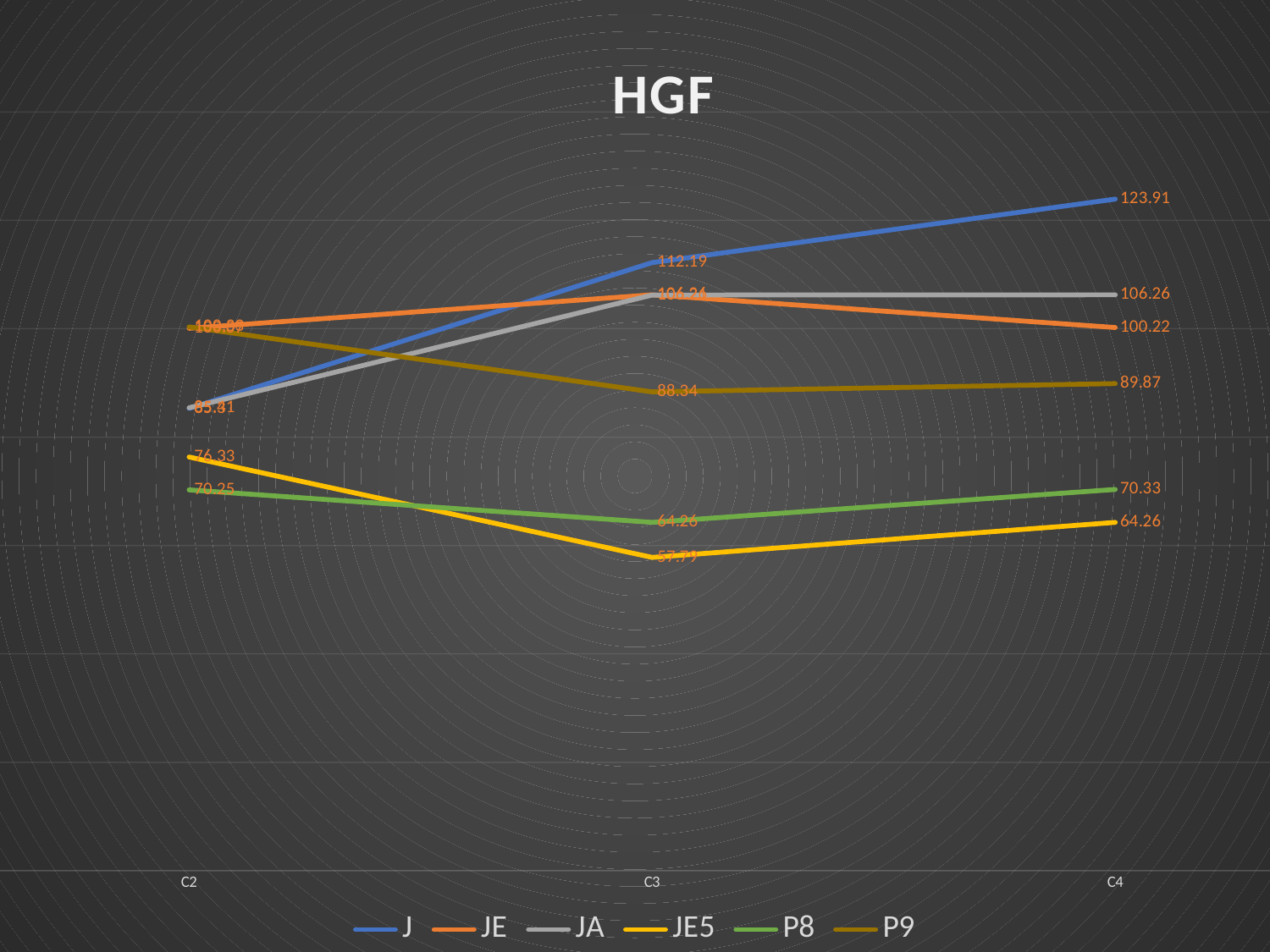
Which series has the highest value at C4? J What is the value for P8 at C2? 70.25 Which series has the lowest value at C4? JE5 What is the value for J at C4? 123.91 How many categories are shown on the x axis? 3 How many series does the legend list? 6 What is the difference between the value for J at C4 and the value for J at C3? 11.72 Does the value for J rise or fall from C2 to C4? rise What type of chart is shown on the slide? line chart What is the title of the chart? HGF What is the value for JE5 at C3? 57.79 What is the value for P9 at C4? 89.87